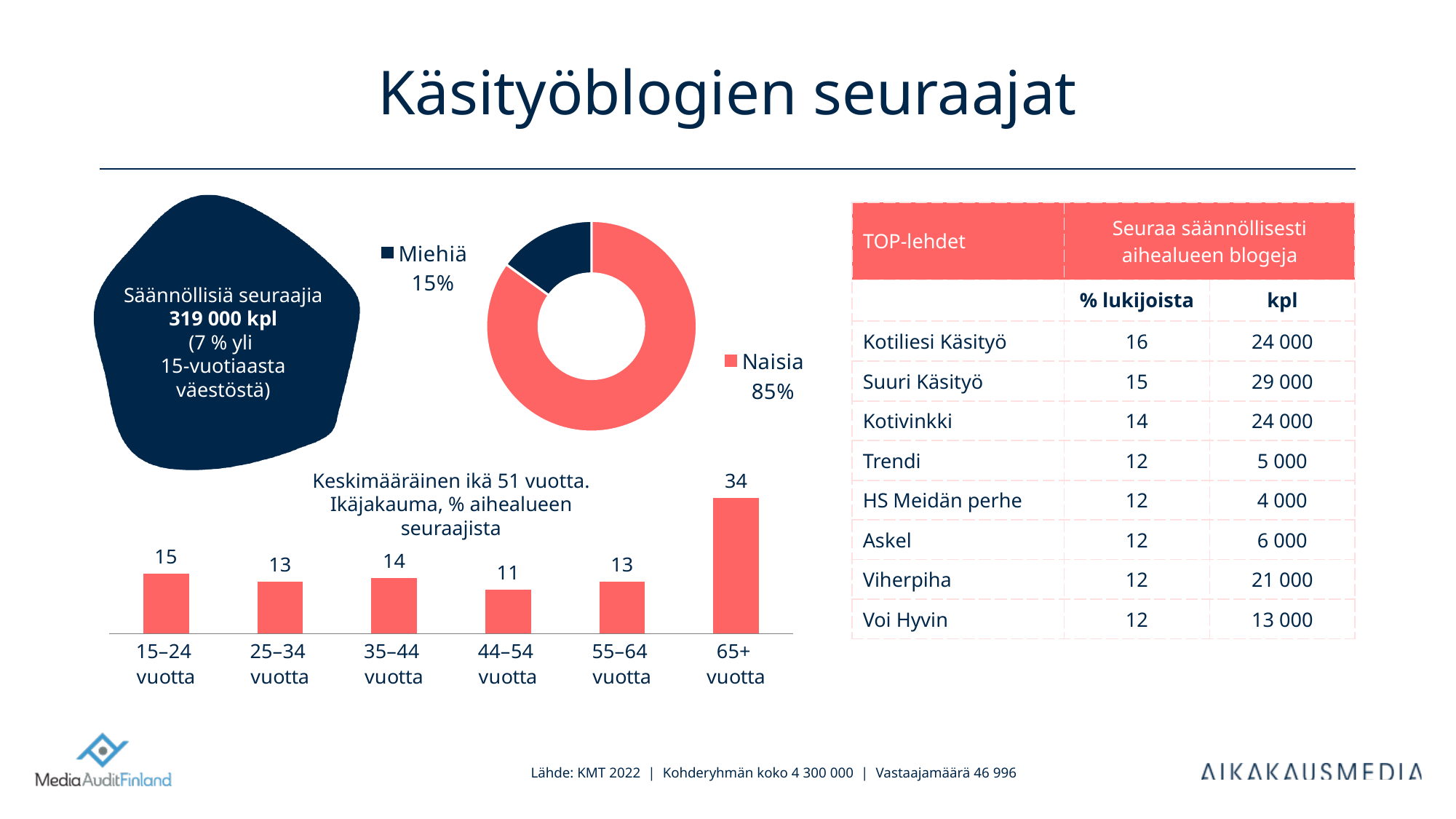
In the age distribution bar chart, which age group has the highest value? 65+ vuotta In the gender donut chart, what share of followers are Naisia? 85% In the age distribution bar chart, which age group has the lowest value? 44–54 vuotta How many age groups are shown in the age distribution bar chart? 6 In the age distribution bar chart, which is larger: the value for 15–24 vuotta or 25–34 vuotta? 15–24 vuotta In the gender donut chart, what share of followers are Miehiä? 15% What type of chart shows the split between Miehiä and Naisia? Donut (pie) chart In the age distribution bar chart, what is the value for 44–54 vuotta? 11 In the age distribution bar chart, what is the value for 65+ vuotta? 34 In the age distribution bar chart, what is the difference between the values for 65+ vuotta and 15–24 vuotta? 19 How many categories does the gender donut chart legend list? 2 What type of chart is used for the age distribution (Ikäjakauma)? Bar chart